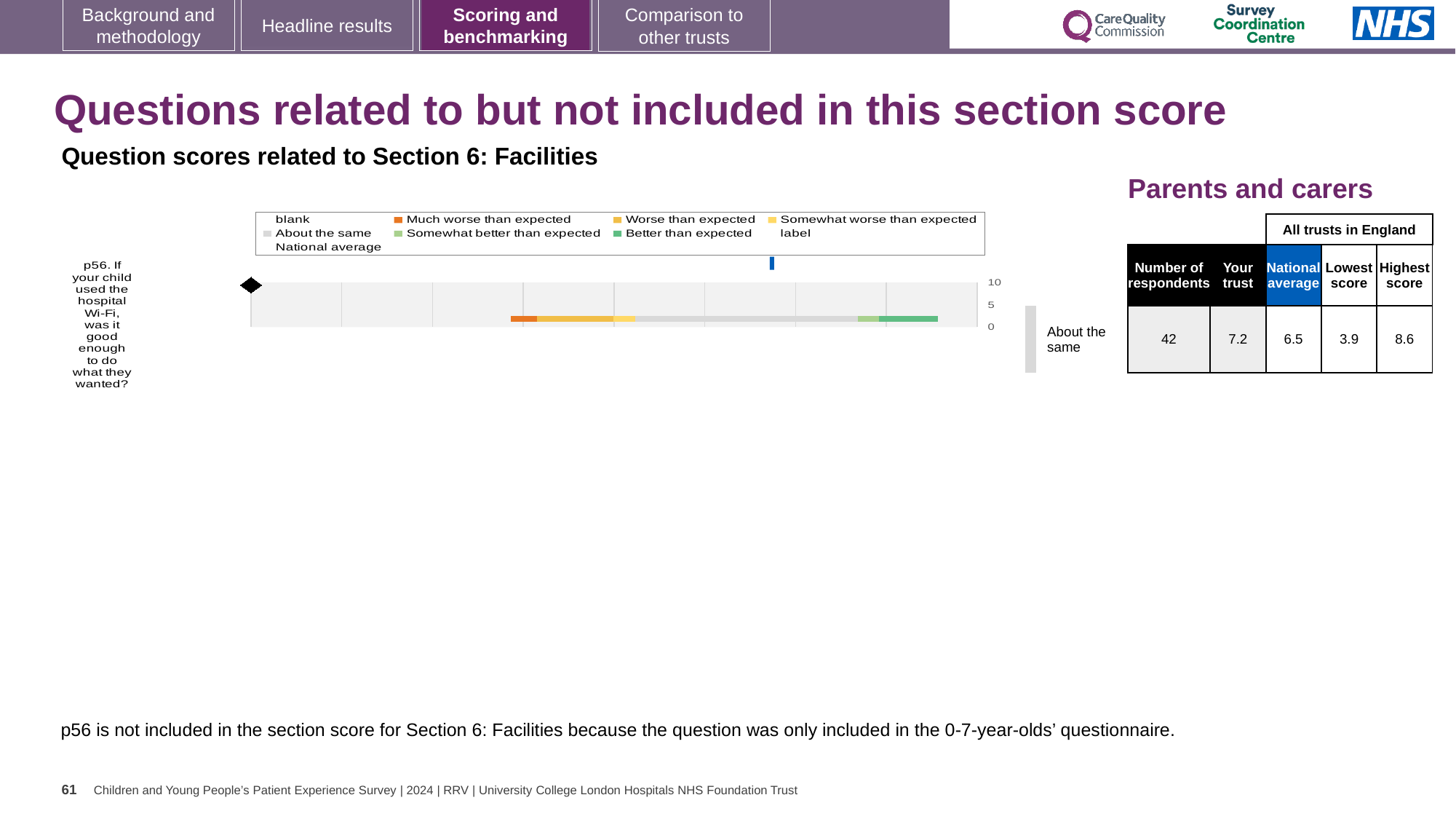
How many respondents answered p56 according to the table next to the chart? 42 According to the table next to the chart, what is the national average score for p56? 6.5 Which question is plotted in the chart? p56. If your child used the hospital Wi-Fi, was it good enough to do what they wanted? According to the table next to the chart, what is the highest score among all trusts in England for p56? 8.6 What kind of chart is shown on the slide? bar chart How many questions (categories) are plotted in the chart? 1 What is the difference between the highest score and the lowest score for p56 in the table next to the chart? 4.7 According to the table next to the chart, what is the lowest score among all trusts in England for p56? 3.9 What benchmark category is the trust given for p56? About the same What is the highest value shown on the chart's axis? 10 Is the 'Your trust' score for p56 higher or lower than the national average? higher According to the table next to the chart, what is the 'Your trust' score for p56? 7.2